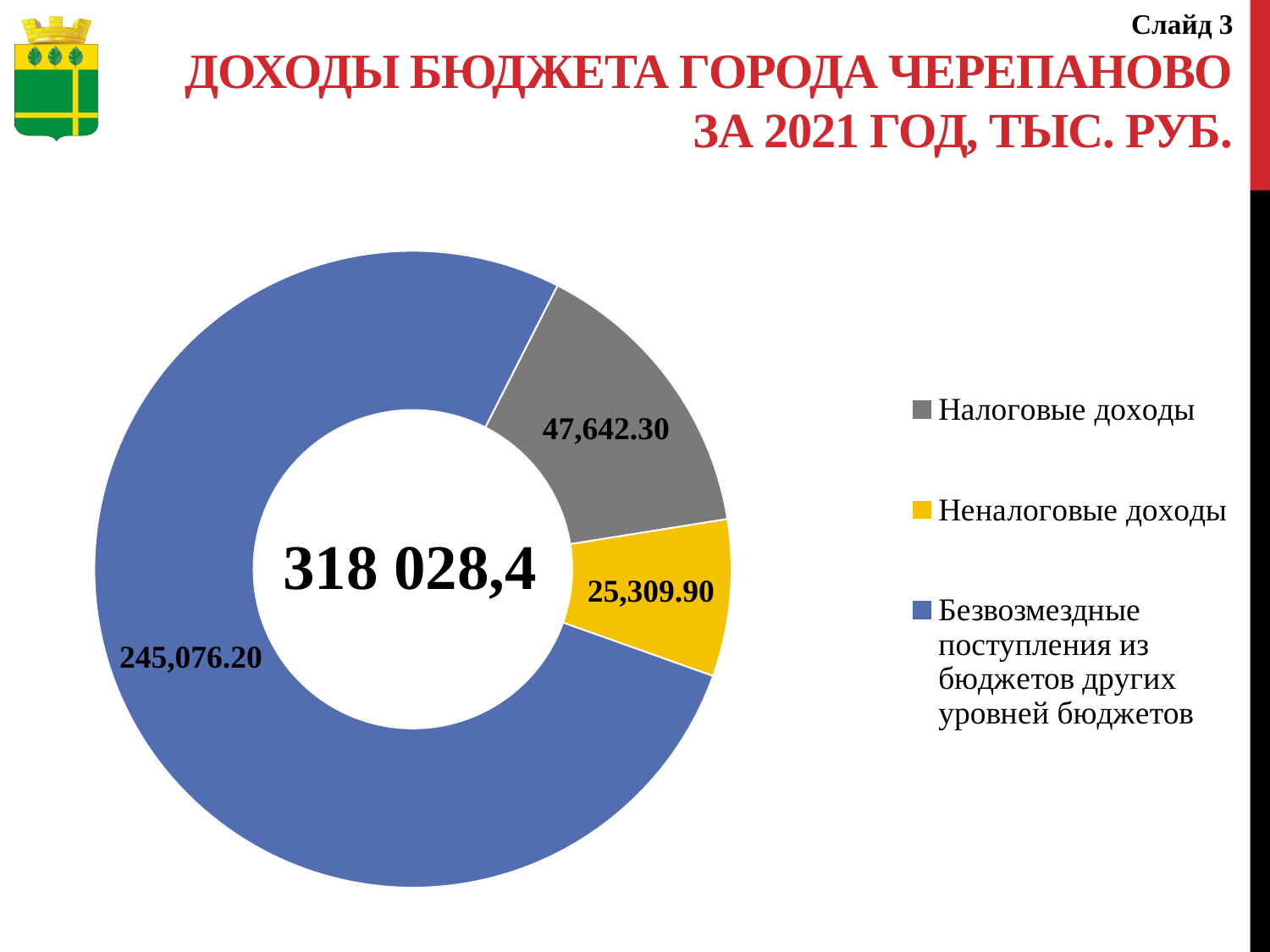
What is the value for Налоговые доходы? 47,642.30 Which category has the smallest value? Неналоговые доходы Which category has the largest value? Безвозмездные поступления из бюджетов других уровней бюджетов What share of the total do Безвозмездные поступления из бюджетов других уровней бюджетов represent? 77.1% What total value is shown in the centre of the doughnut chart? 318 028,4 What is the value for Неналоговые доходы? 25,309.90 What is the value for Безвозмездные поступления из бюджетов других уровней бюджетов? 245,076.20 Which is larger: Налоговые доходы or Неналоговые доходы? Налоговые доходы How many categories (slices) does the chart have? 3 What colour is the slice for Неналоговые доходы? Yellow What type of chart is shown on the slide? Doughnut (pie) chart What is the difference between Налоговые доходы and Неналоговые доходы? 22,332.40